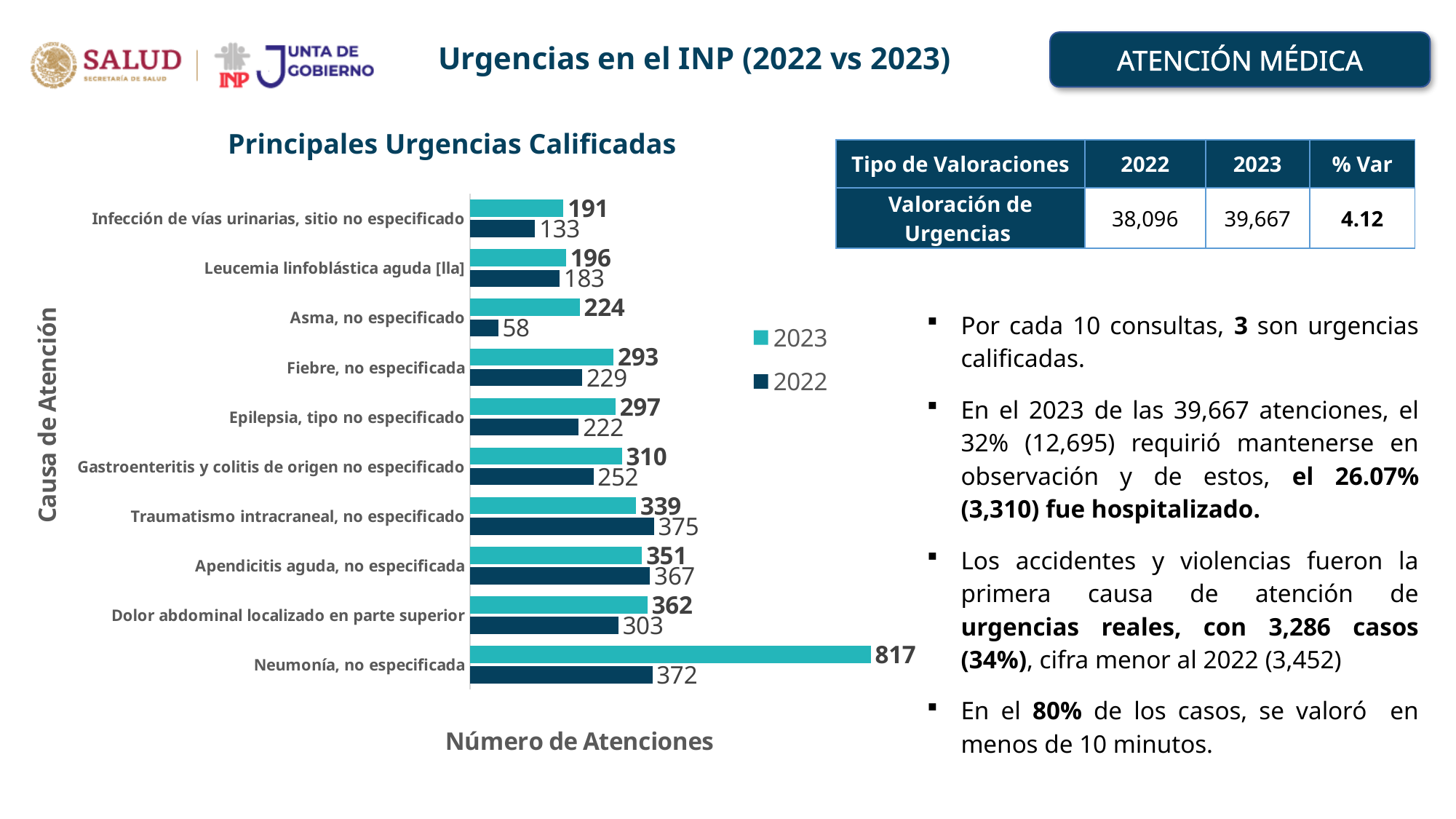
For Traumatismo intracraneal, no especificado, which year has the larger value, 2022 or 2023? 2022 How many categories (causes of attention) are shown in the chart? 10 What is the 2022 value for Asma, no especificado? 58 What is the difference between the 2023 and 2022 values for Neumonía, no especificada? 445 How many series does the legend list? 2 What kind of chart is shown on the slide? Bar chart What is the title of the chart? Principales Urgencias Calificadas What is the 2023 value for Fiebre, no especificada? 293 What is the difference between the 2023 and 2022 values for Asma, no especificado? 166 Which category has the highest 2023 value? Neumonía, no especificada Which category has the lowest 2022 value? Asma, no especificado What is the 2023 value for Neumonía, no especificada? 817